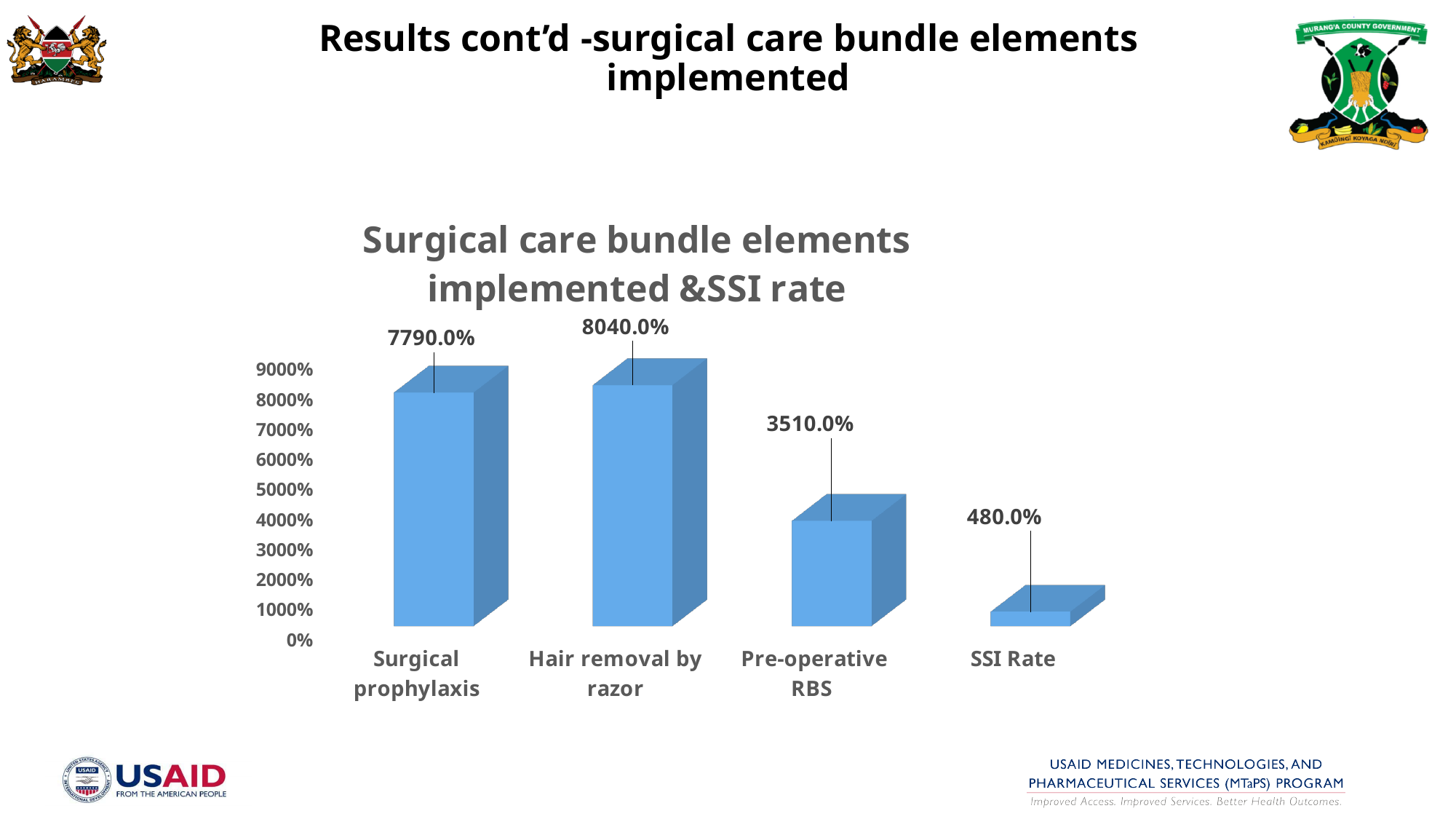
What is the value for Hair removal by razor? 8040.0% What is the title of the chart? Surgical care bundle elements implemented &SSI rate What is the difference between the values for Hair removal by razor and Surgical prophylaxis? 250.0% What is the value for Pre-operative RBS? 3510.0% What kind of chart is shown on the slide? Bar chart What is the value for SSI Rate? 480.0% How many categories are shown on the chart? 4 What is the value for Surgical prophylaxis? 7790.0% Which is larger, the value for Surgical prophylaxis or the value for Pre-operative RBS? Surgical prophylaxis What is the difference between the values for Pre-operative RBS and SSI Rate? 3030.0% Which category has the lowest value? SSI Rate Which category has the highest value? Hair removal by razor